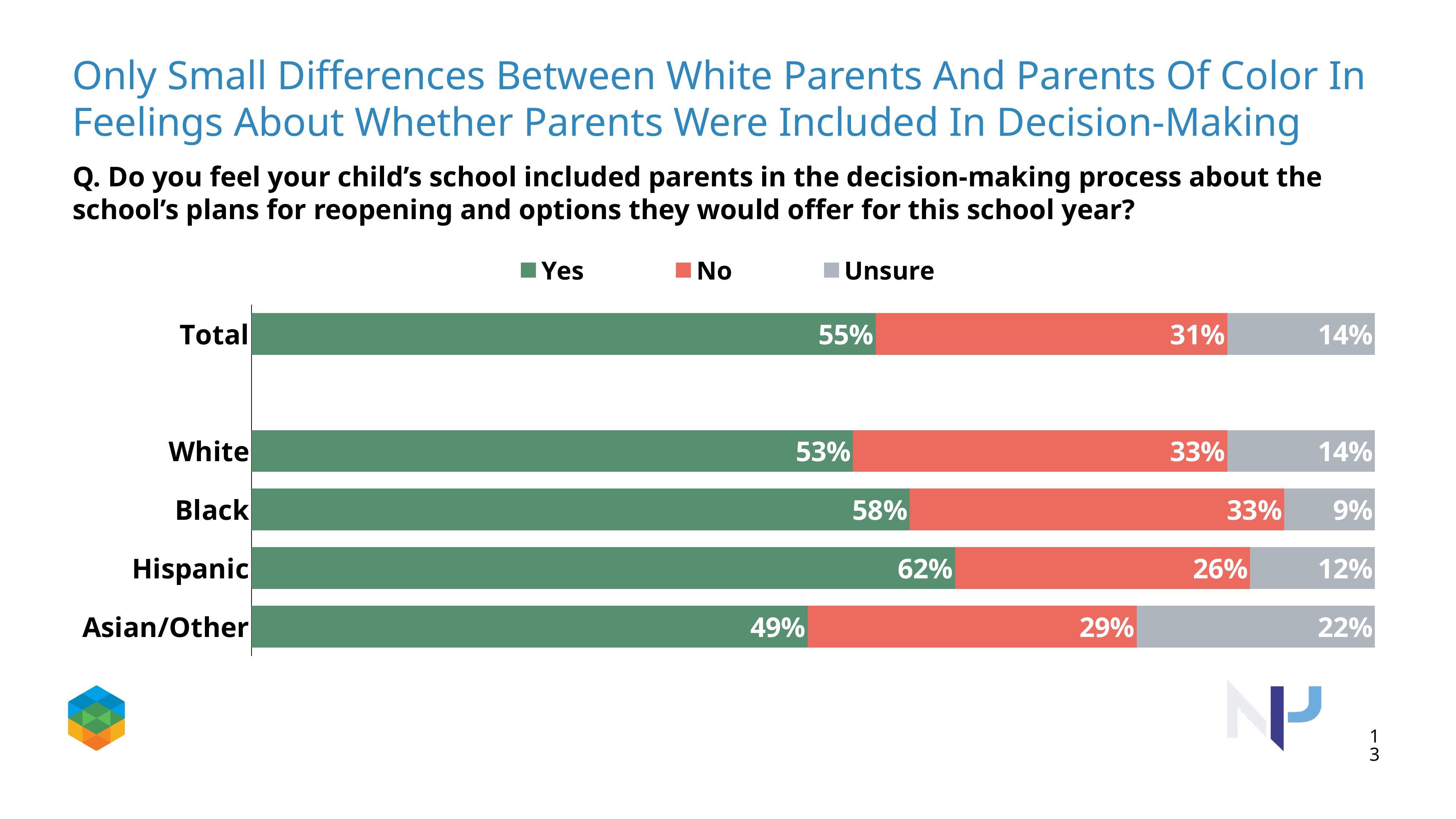
Which colour represents the No responses in the chart? Red Which group has the highest Yes percentage? Hispanic What percentage of Hispanic parents answered Yes? 62% What percentage of Asian/Other parents answered Unsure? 22% Which is larger, the No percentage for White parents or for Hispanic parents? White How many series does the legend list? 3 Which group has the lowest Unsure percentage? Black What kind of chart is shown on the slide? Stacked bar chart What is the difference between the Yes percentages for Hispanic and Asian/Other parents? 13% What is the No value for the Total group? 31% What is the total of the Black bar (Yes + No + Unsure)? 100% How many groups (bars) are shown in the chart? 5